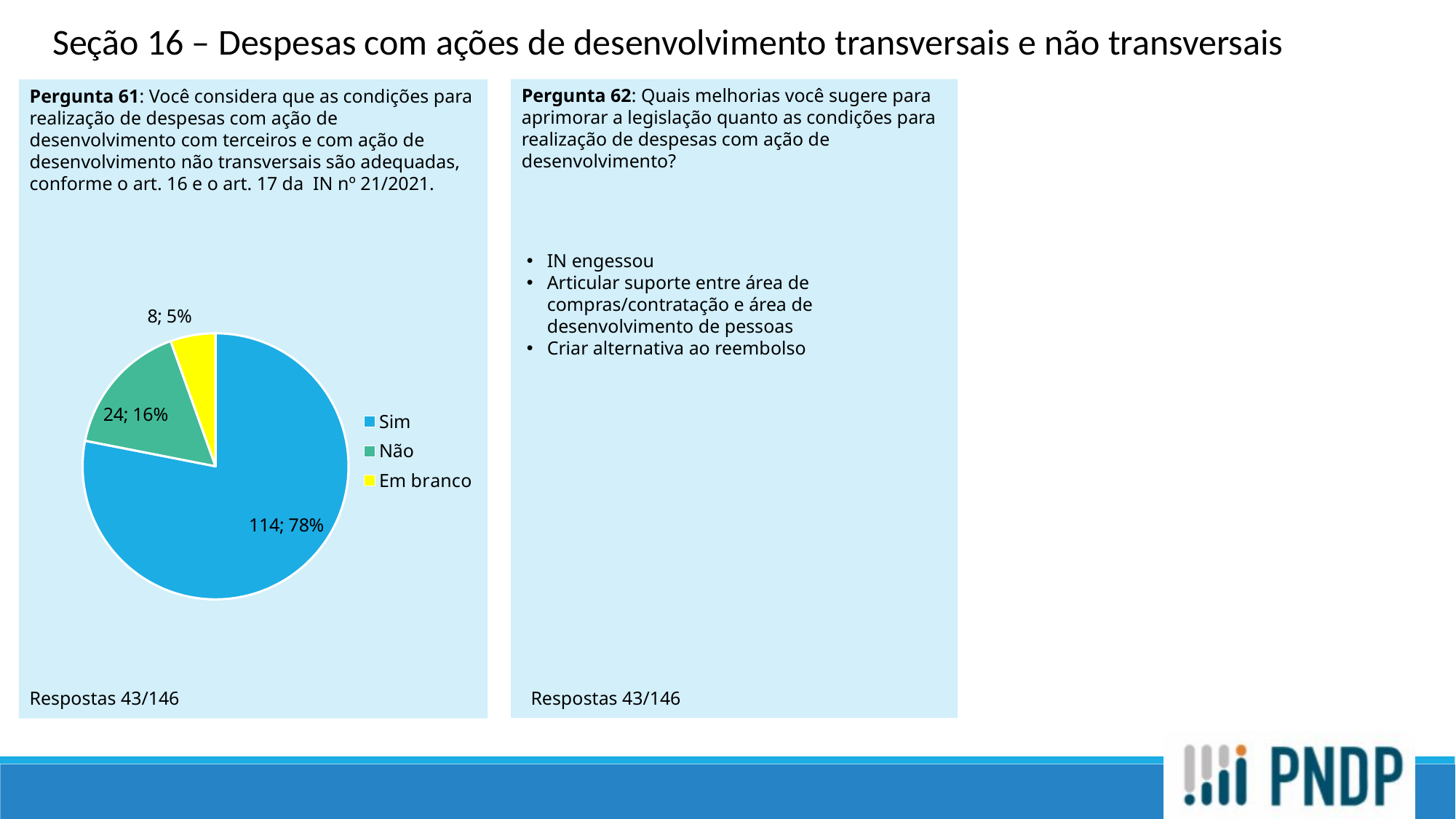
What is the difference between the counts for 'Sim' and 'Não' in the pie chart? 90 Which category has the largest slice in the pie chart? Sim What is the count shown for the 'Não' slice of the pie chart? 24 What is the count shown for the 'Sim' slice of the pie chart? 114 What percentage of the pie does the 'Sim' slice represent? 78% How many slices does the pie chart have? 3 What percentage of the pie does the 'Em branco' slice represent? 5% What percentage of the pie does the 'Não' slice represent? 16% Which category has the smallest slice in the pie chart? Em branco What is the count shown for the 'Em branco' slice of the pie chart? 8 What kind of chart is shown under Pergunta 61? pie chart How many entries does the pie chart's legend list? 3